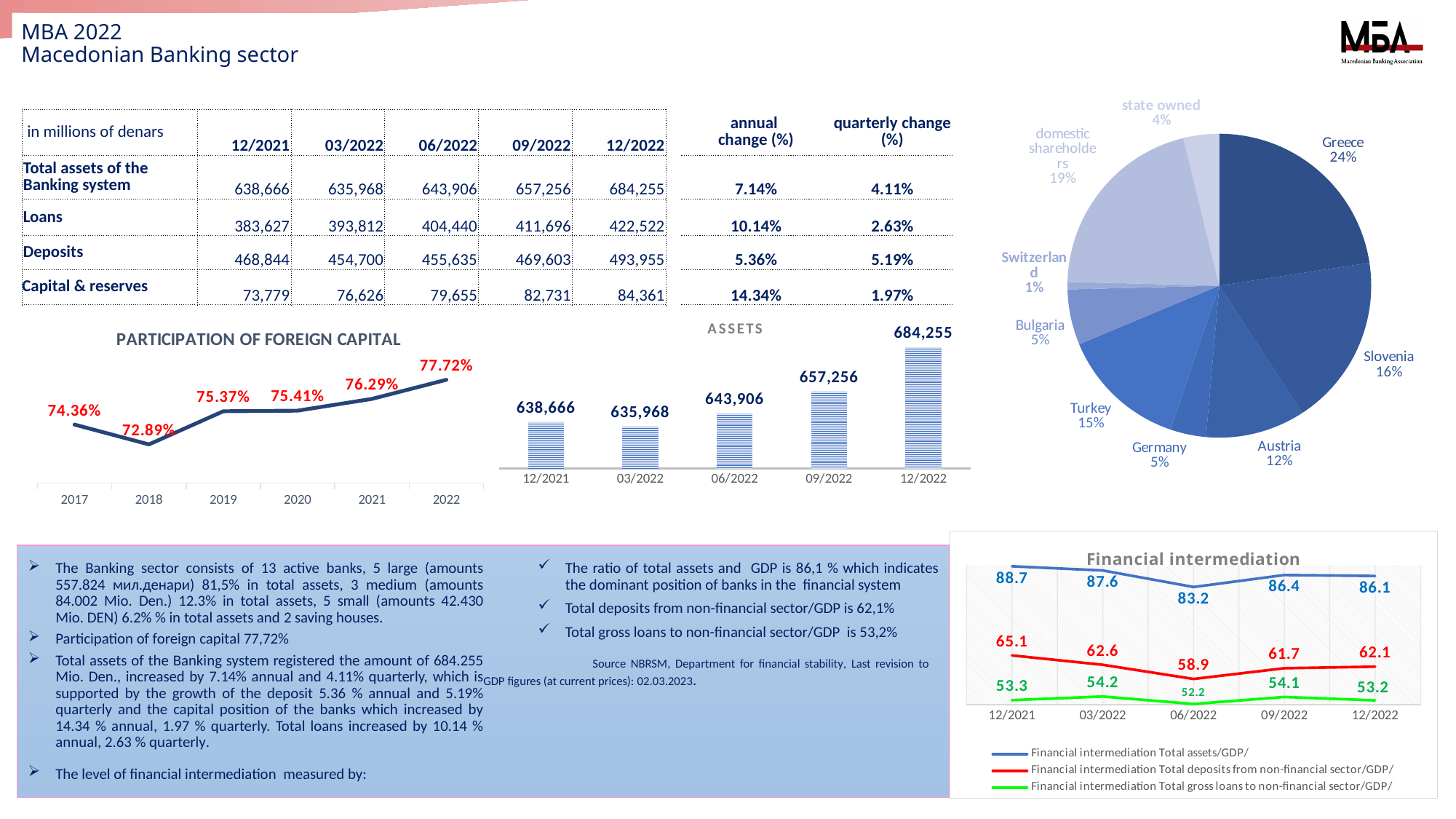
In the ASSETS chart, what is the value for 12/2022? 684,255 How many slices does the pie chart have? 9 In the pie chart, which slice is the smallest? Switzerland What kind of chart is the ASSETS chart? Bar chart In the Financial intermediation chart, what is the value of Total deposits from non-financial sector/GDP at 06/2022? 58.9 How many series does the legend of the Financial intermediation chart list? 3 In the PARTICIPATION OF FOREIGN CAPITAL chart, what is the difference between the 2022 and 2017 values? 3.36 percentage points In the PARTICIPATION OF FOREIGN CAPITAL chart, which year has the lowest value? 2018 In the ASSETS chart, which period has the lowest value? 03/2022 In the PARTICIPATION OF FOREIGN CAPITAL chart, what is the value for 2022? 77.72% In the pie chart, what share does Greece hold? 24% In the ASSETS chart, what is the difference between the 12/2022 and 09/2022 values? 26,999